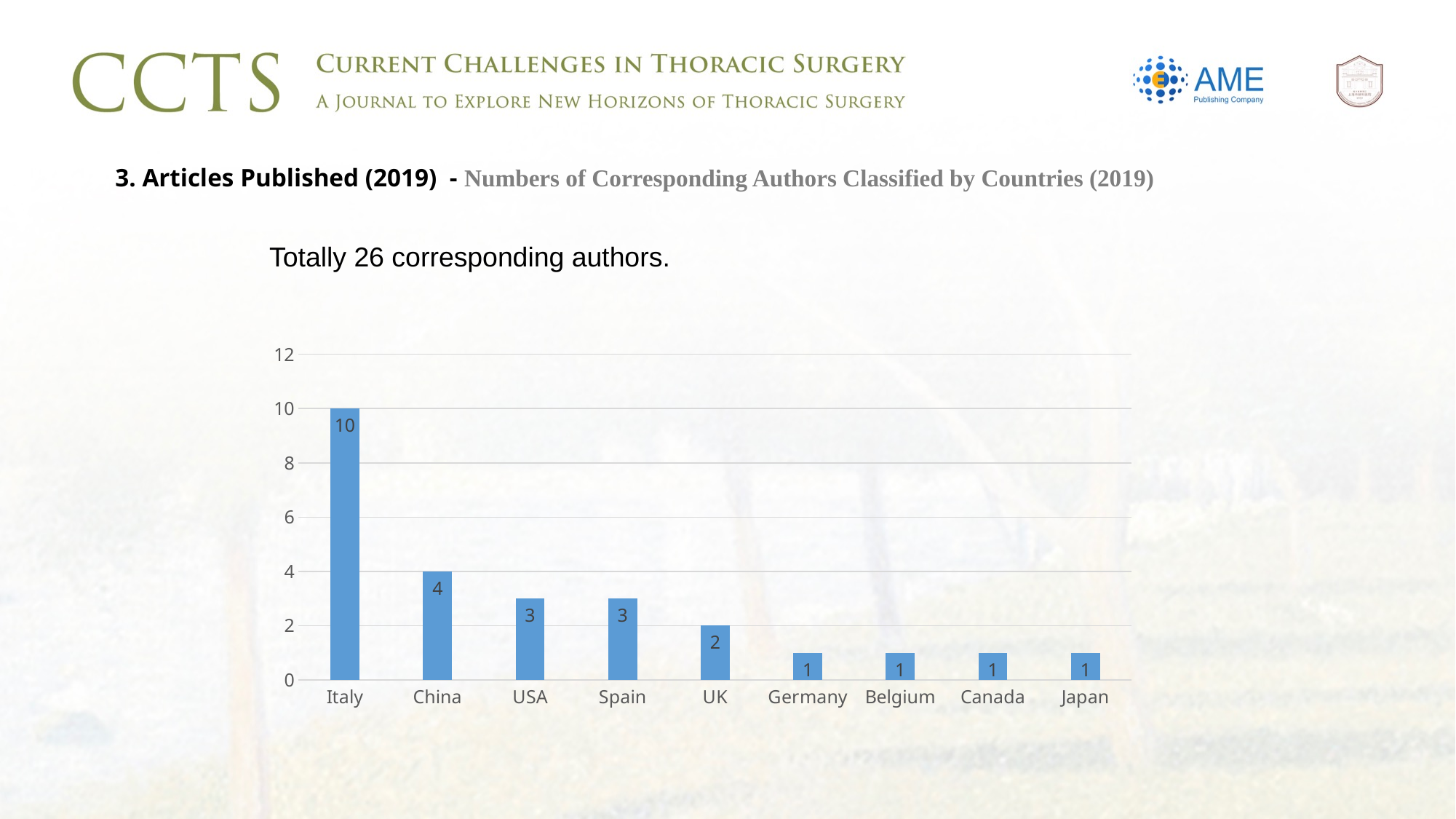
How many corresponding authors are from Italy? 10 Do the values rise or fall from left to right along the x axis? fall What kind of chart is shown on the slide? bar chart How many corresponding authors are from the UK? 2 What is the value shown for China? 4 Which has a larger value, China or USA? China What is the difference between the values for Italy and China? 6 How many countries have a value of 1? 4 What is the total number of corresponding authors stated on the slide? 26 Is the value for Italy greater or less than 8? greater How many countries are shown on the x axis of the chart? 9 Which country has the highest number of corresponding authors? Italy